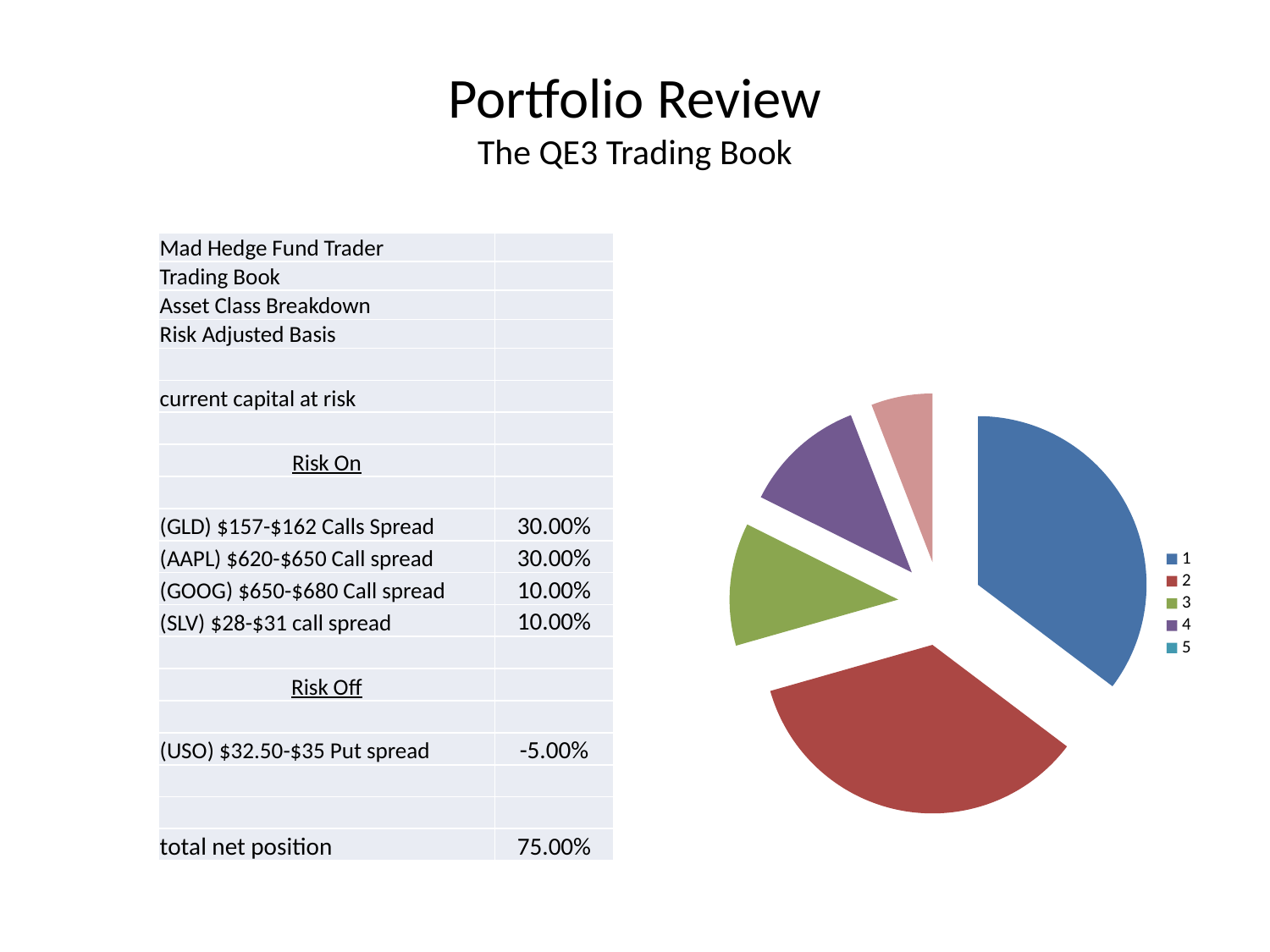
What colour is legend entry 1 in the pie chart? blue Which of the two slices is larger in the pie chart, the red slice (2) or the purple slice (4)? red slice (2) How many slices are visible in the pie chart? 5 How many entries does the legend of the pie chart list? 5 Which of the two slices is larger in the pie chart, the blue slice (1) or the green slice (3)? blue slice (1) Which colour slice is the smallest in the pie chart? pink Which of the two slices is larger in the pie chart, the blue slice (1) or the pink slice? blue slice (1) What kind of chart is shown on the slide? pie chart What are the labels listed in the pie chart's legend? 1, 2, 3, 4, 5